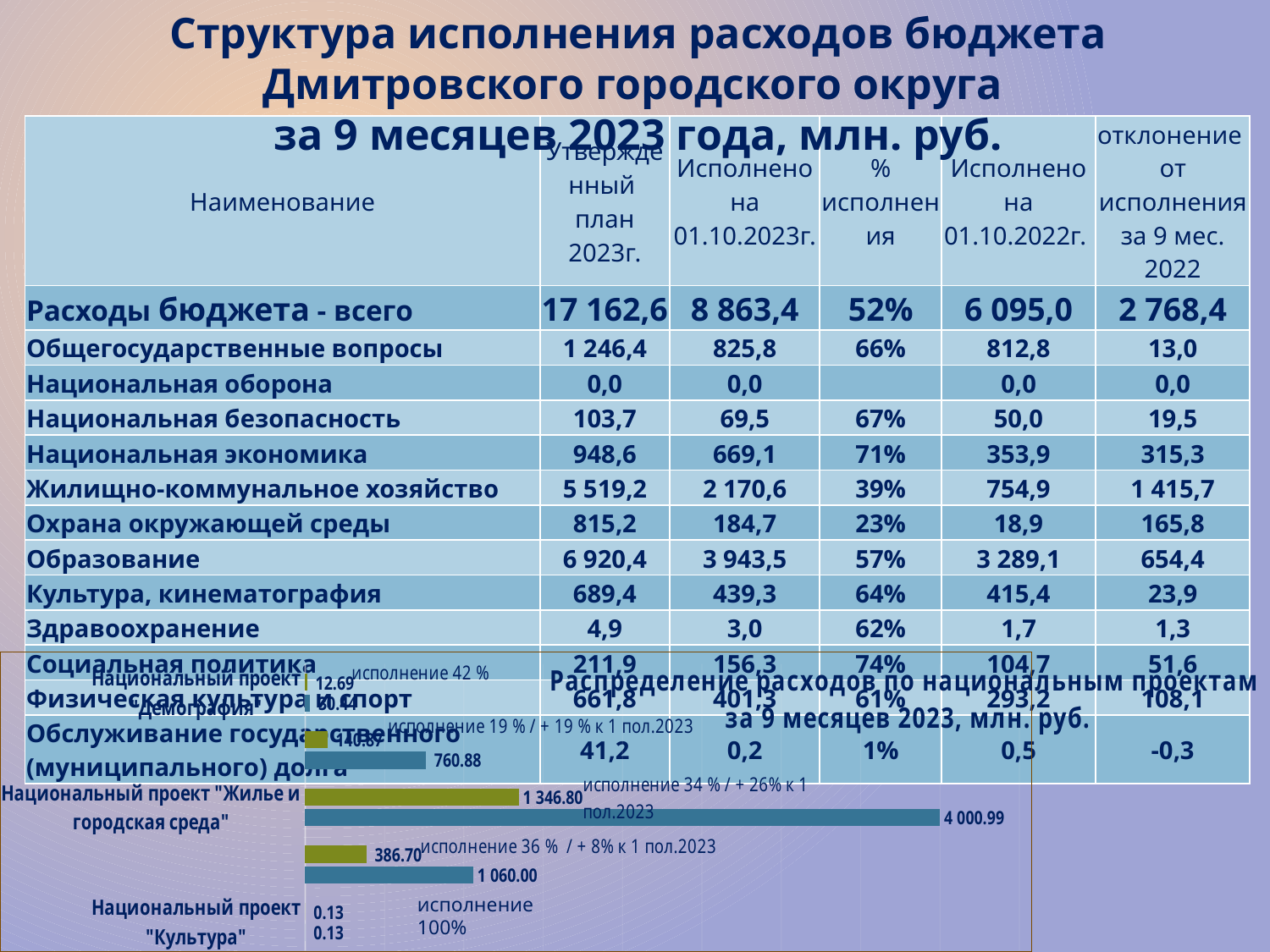
In the chart 'Распределение расходов по национальным проектам', which national project has the longest bar? Национальный проект "Жилье и городская среда" In the chart 'Распределение расходов по национальным проектам', what is the value of the green bar for Национальный проект "Жилье и городская среда"? 1 346.80 In the chart 'Распределение расходов по национальным проектам', what is the difference between the blue bar (4 000.99) and the green bar (1 346.80) for Национальный проект "Жилье и городская среда"? 2 654.19 In the chart 'Распределение расходов по национальным проектам', what is the value of the blue bar for Национальный проект "Жилье и городская среда"? 4 000.99 In the chart 'Распределение расходов по национальным проектам', how many national project categories are plotted? 5 What is the title of the chart at the bottom of the slide? Распределение расходов по национальным проектам за 9 месяцев 2023, млн. руб. In the chart 'Распределение расходов по национальным проектам', which is larger: the blue bar for "Жилье и городская среда" or the blue bar for "Культура"? "Жилье и городская среда" In the chart 'Распределение расходов по национальным проектам', what is the value of the green bar for Национальный проект "Демография"? 12.69 What kind of chart is shown at the bottom of the slide? bar chart In the chart 'Распределение расходов по национальным проектам', what execution percentage is annotated next to Национальный проект "Культура"? исполнение 100% In the chart 'Распределение расходов по национальным проектам', what value is shown for Национальный проект "Культура"? 0.13